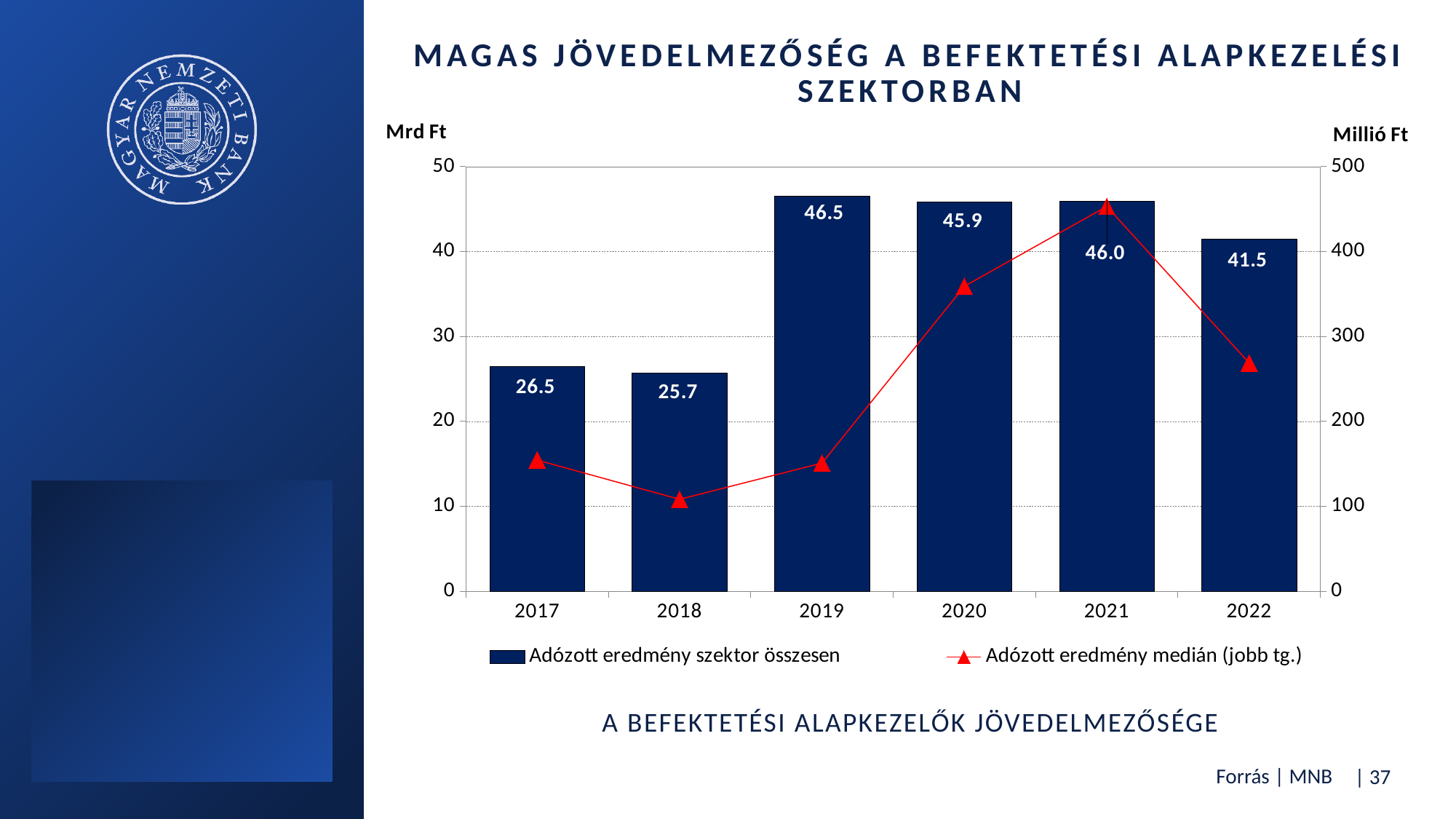
What is the value of 'Adózott eredmény szektor összesen' for 2017? 26.5 Which is larger, the 'Adózott eredmény szektor összesen' value for 2020 or for 2021? 2021 Is the 'Adózott eredmény medián (jobb tg.)' value for 2021 greater or less than 400 on the right axis? greater What is the value of 'Adózott eredmény szektor összesen' for 2019? 46.5 Is the 'Adózott eredmény medián (jobb tg.)' value for 2018 greater or less than 200 on the right axis? less How many series does the chart legend list? 2 Which year has the highest value for 'Adózott eredmény szektor összesen'? 2019 How many years are shown on the x axis of the chart? 6 What unit is shown on the right-hand axis of the chart? Millió Ft Which year has the lowest value for 'Adózott eredmény szektor összesen'? 2018 What is the difference between the 'Adózott eredmény szektor összesen' values for 2019 and 2022? 5.0 What is the value of 'Adózott eredmény szektor összesen' for 2022? 41.5